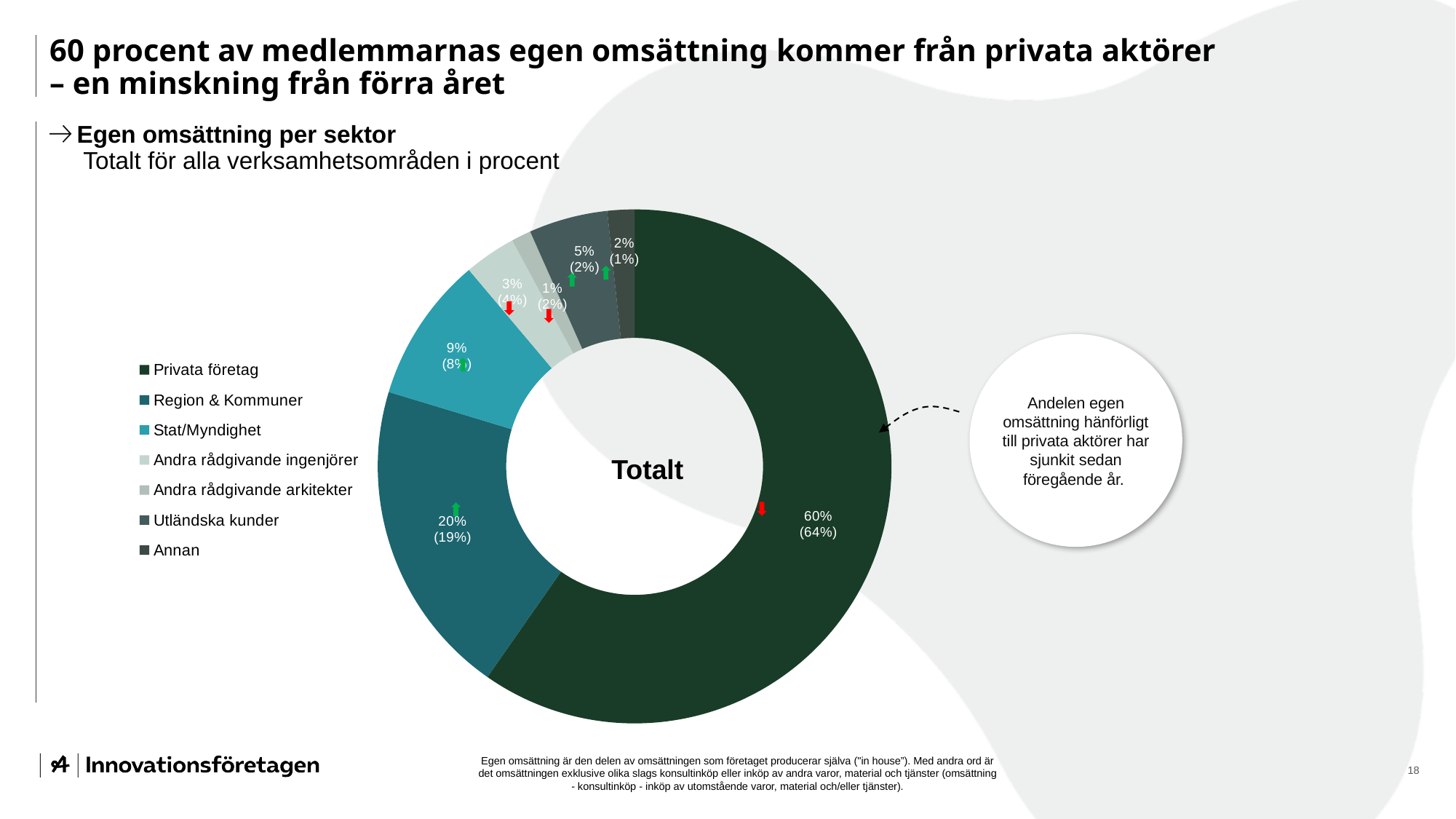
What share of egen omsättning comes from Region & Kommuner? 20% Which has a larger share: Stat/Myndighet or Utländska kunder? Stat/Myndighet What share of egen omsättning comes from Privata företag? 60% What was the previous year's share for Privata företag, shown in parentheses? 64% What kind of chart is shown on the slide? Pie chart (donut) How many sectors does the legend list? 7 What share of egen omsättning comes from Utländska kunder? 5% Which sector has the largest share of egen omsättning? Privata företag What word is written in the centre of the donut chart? Totalt What share of egen omsättning comes from Stat/Myndighet? 9% What is the difference in percentage points between the shares of Privata företag and Region & Kommuner? 40 percentage points Which sector has the smallest share of egen omsättning? Andra rådgivande arkitekter